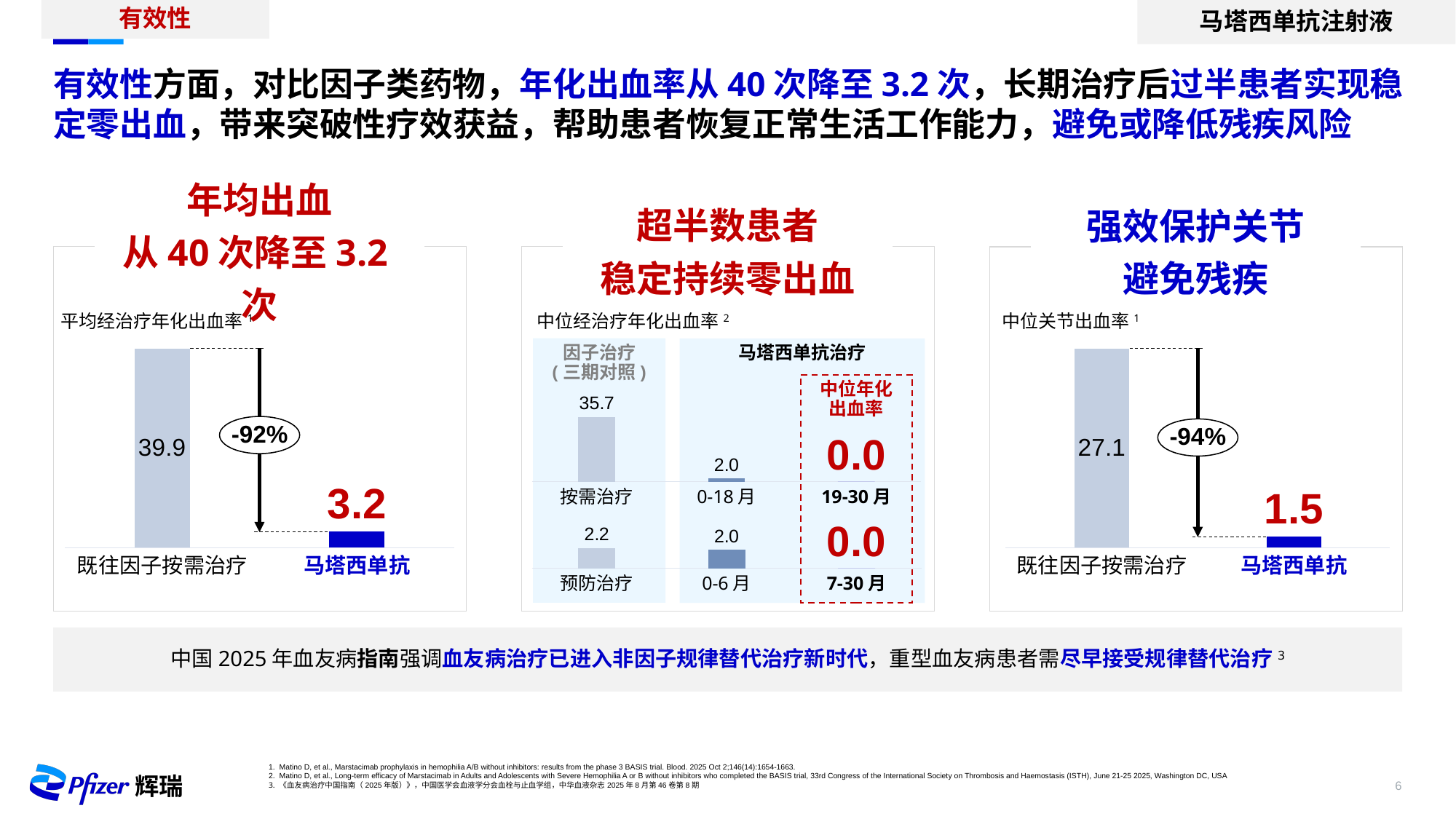
In the left chart (平均经治疗年化出血率), which category has the higher value? 既往因子按需治疗 In the left chart (平均经治疗年化出血率), what is the difference between the value for 既往因子按需治疗 and the value for 马塔西单抗? 36.7 In the middle chart (中位经治疗年化出血率), what is the value for 马塔西单抗治疗 at 0-6 月 under 预防治疗? 2.0 In the left chart (平均经治疗年化出血率), what is the value for 马塔西单抗? 3.2 In the right chart (中位关节出血率), what is the value for 既往因子按需治疗? 27.1 In the right chart (中位关节出血率), what percentage reduction is shown between the two bars? -94% In the middle chart (中位经治疗年化出血率), what is the value for 因子治疗（三期对照） under 按需治疗? 35.7 In the right chart (中位关节出血率), what is the difference between the value for 既往因子按需治疗 and the value for 马塔西单抗? 25.6 In the middle chart (中位经治疗年化出血率), what is the 中位年化出血率 for 马塔西单抗治疗 at 19-30 月? 0.0 In the left chart (平均经治疗年化出血率), what is the value for 既往因子按需治疗? 39.9 In the left chart (平均经治疗年化出血率), what percentage reduction is shown between the two bars? -92% In the right chart (中位关节出血率), what is the value for 马塔西单抗? 1.5